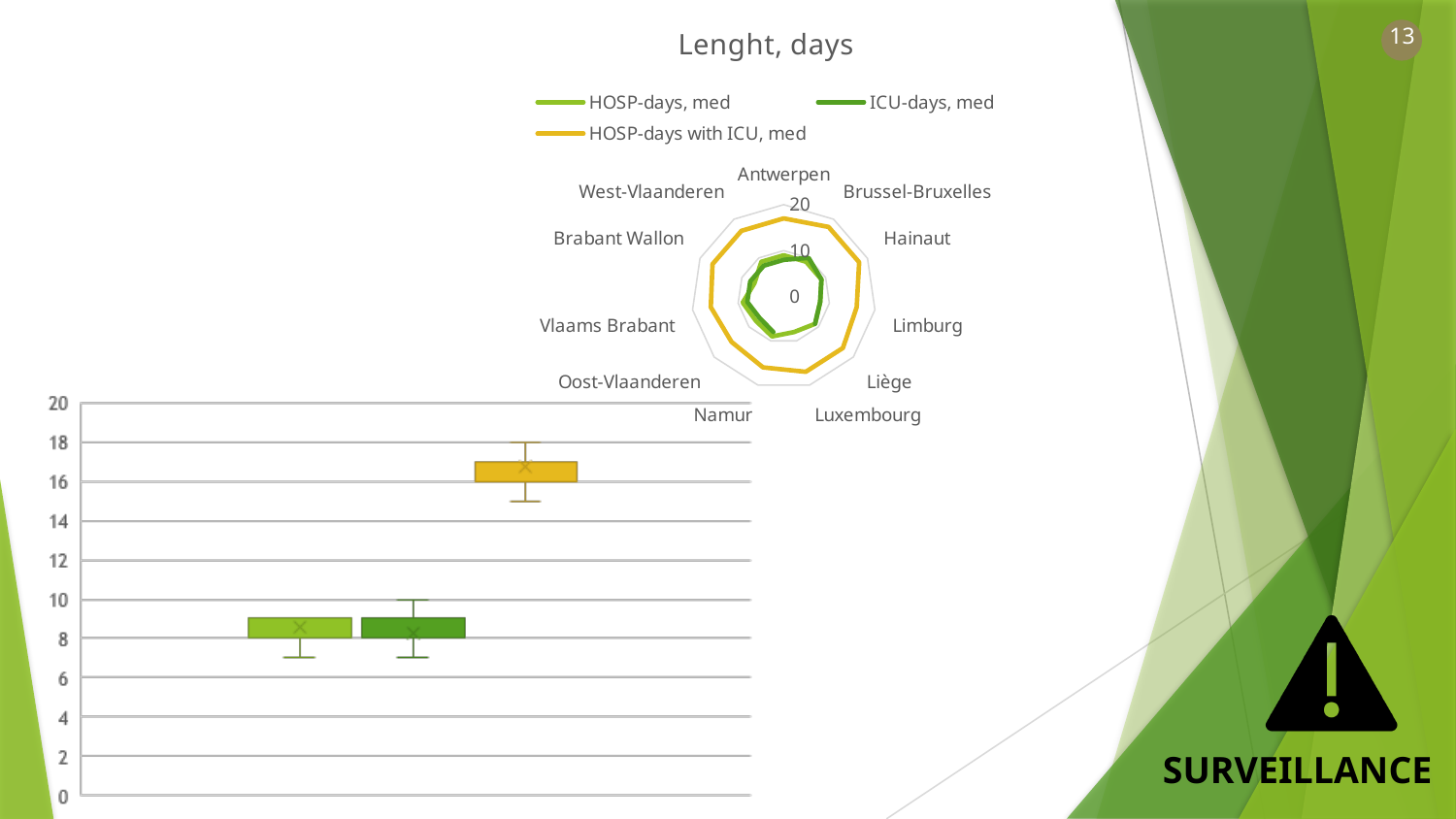
In the chart titled "Lenght, days", which series is drawn in yellow? HOSP-days with ICU, med What kind of chart is the chart at the bottom left of the slide? box plot In the chart titled "Lenght, days", is the value of ICU-days, med for Antwerpen greater or less than 10? less In the chart titled "Lenght, days", is the value of HOSP-days with ICU, med for Antwerpen greater or less than 10? greater What is the title of the radar chart at the top of the slide? Lenght, days What kind of chart is the chart titled "Lenght, days"? radar chart In the chart at the bottom left of the slide, is the yellow box positioned greater or less than 14 on the vertical axis? greater How many provinces (categories) are plotted on the chart titled "Lenght, days"? 11 How many series does the legend of the chart titled "Lenght, days" list? 3 In the chart titled "Lenght, days", which series has the largest values across the provinces: HOSP-days with ICU, med or ICU-days, med? HOSP-days with ICU, med How many boxes are plotted in the chart at the bottom left of the slide? 3